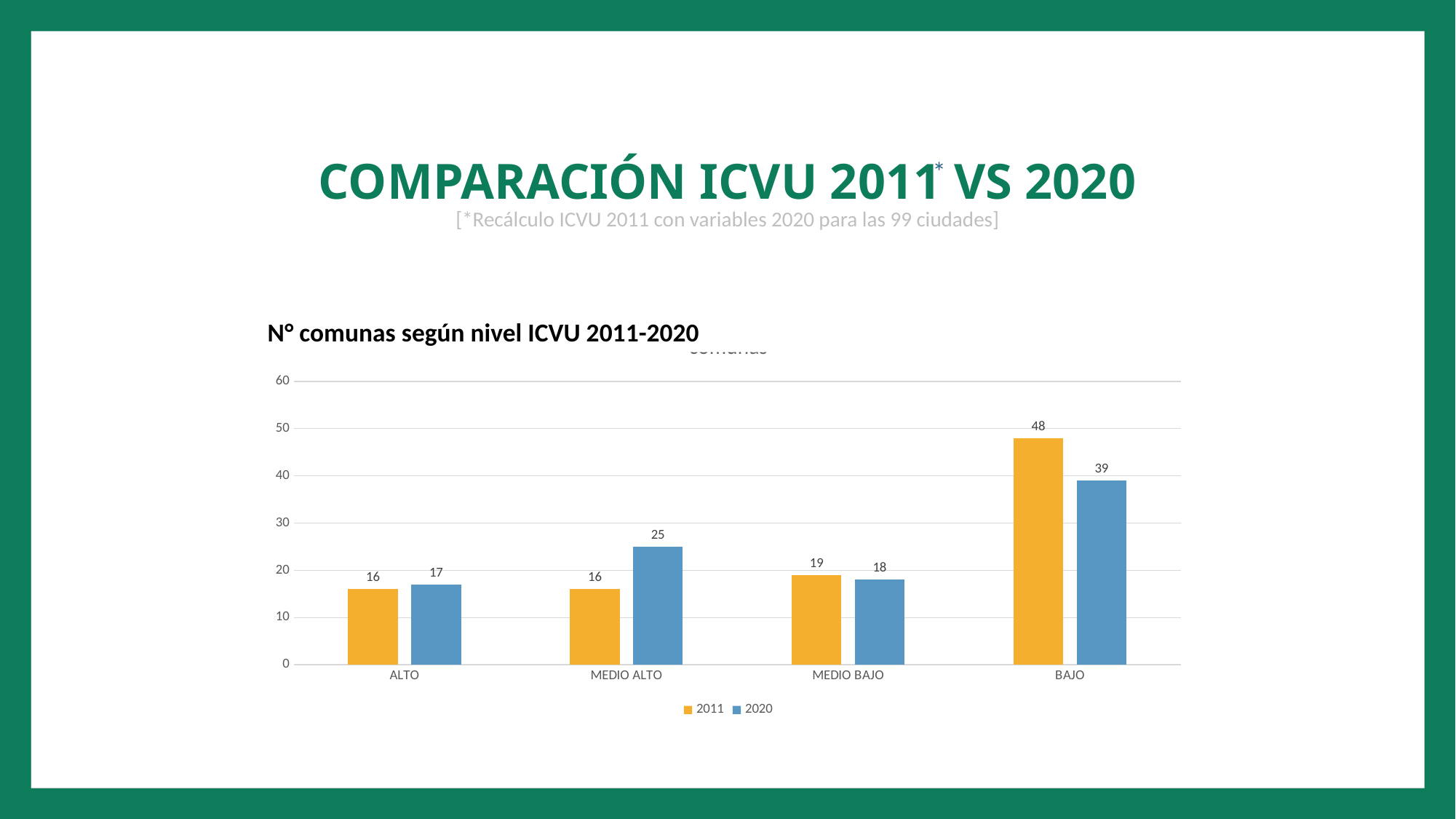
Which category has the highest value for the 2011 series? BAJO How many categories are shown on the x axis? 4 What is the value for 2020 in the MEDIO ALTO category? 25 What is the difference between the 2011 and 2020 values in the BAJO category? 9 Is the value for 2011 in the BAJO category greater or less than 40? greater What is the value for 2011 in the ALTO category? 16 Which colour represents the 2011 series in the chart? orange Which category has the lowest value for the 2020 series? ALTO What kind of chart is shown on the slide? bar chart What is the value for 2020 in the BAJO category? 39 How many series does the legend list? 2 In the MEDIO ALTO category, which series has the larger value, 2011 or 2020? 2020